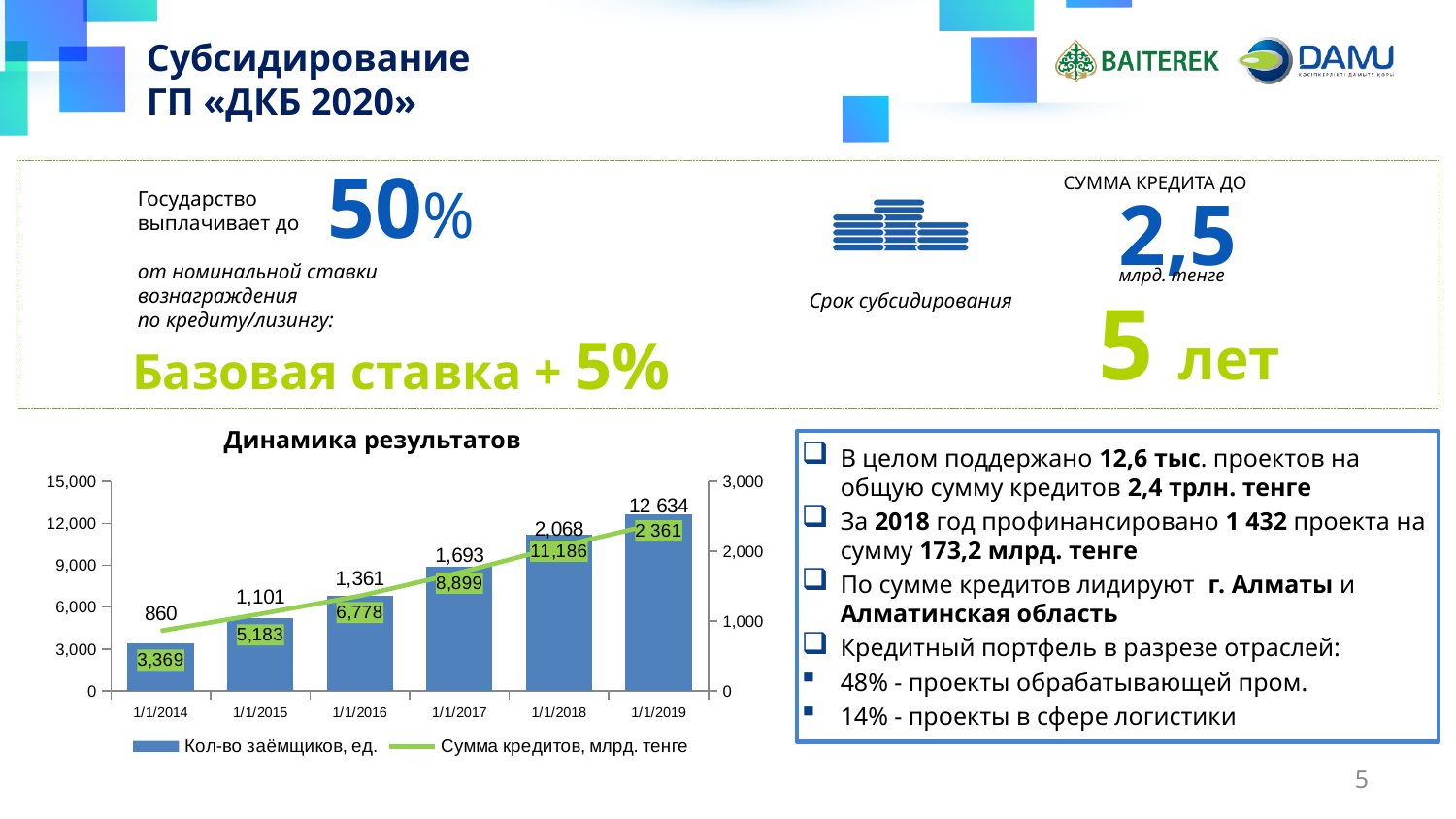
Which date has the highest value for Кол-во заёмщиков, ед.? 1/1/2019 What is the value of Сумма кредитов, млрд. тенге for 1/1/2017? 1,693 How many series does the chart legend list? 2 What is the value of Сумма кредитов, млрд. тенге for 1/1/2014? 860 What is the value of Кол-во заёмщиков, ед. for 1/1/2016? 6,778 What is the title of the chart on the slide? Динамика результатов What is the value of Кол-во заёмщиков, ед. for 1/1/2019? 12 634 What is the difference between the Кол-во заёмщиков, ед. values for 1/1/2018 and 1/1/2017? 2,287 Do the Кол-во заёмщиков, ед. values rise or fall from 1/1/2014 to 1/1/2019? rise Which date has the lowest value for Сумма кредитов, млрд. тенге? 1/1/2014 Which is larger: the Сумма кредитов, млрд. тенге value for 1/1/2015 or for 1/1/2016? 1/1/2016 How many dates are shown on the x axis of the chart? 6